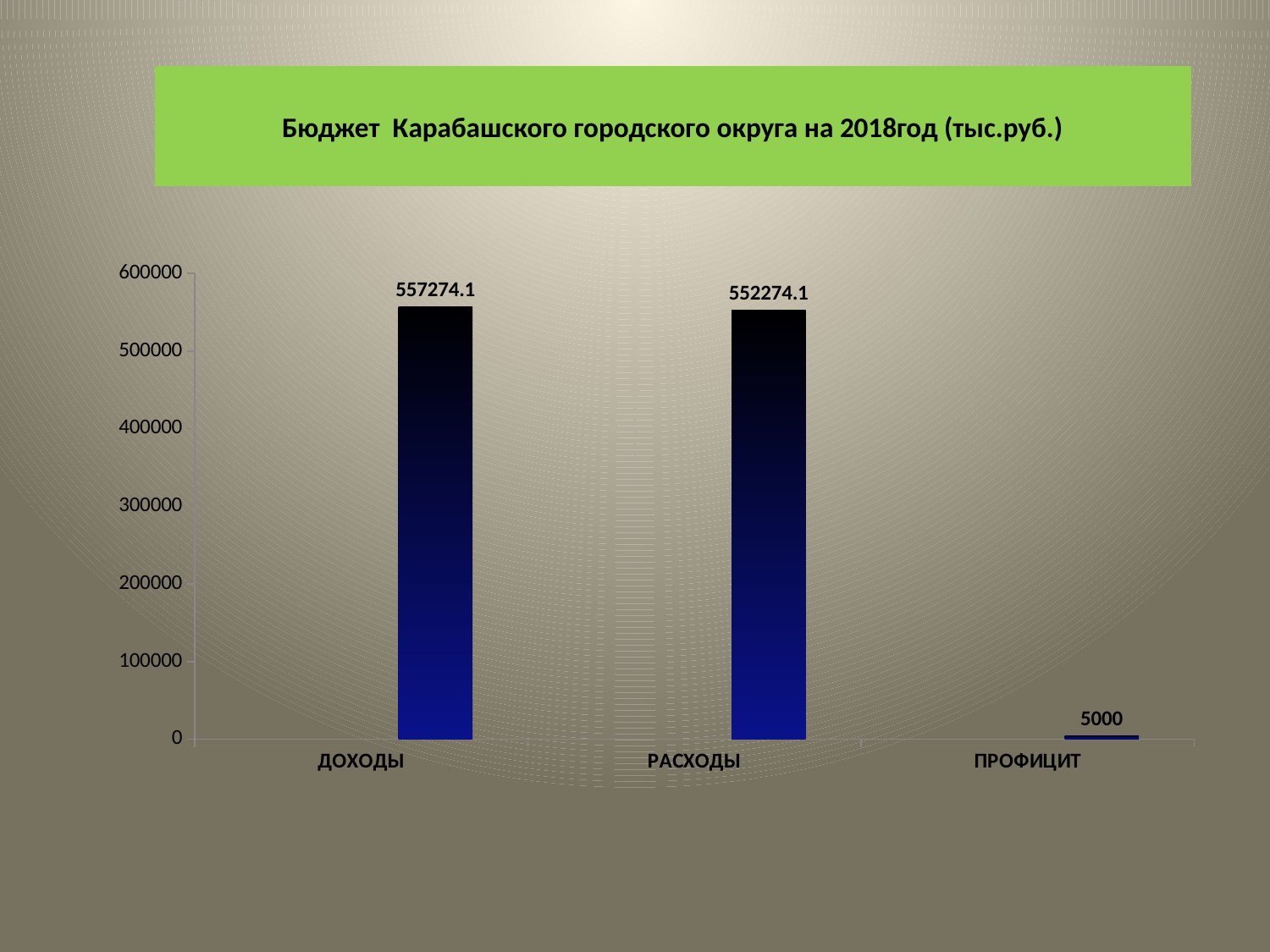
Which category has the highest value? ДОХОДЫ How many categories are shown on the chart? 3 What is the value for ПРОФИЦИТ? 5000 Is the value for ПРОФИЦИТ greater or less than 100000? less Which is larger, ДОХОДЫ or ПРОФИЦИТ? ДОХОДЫ What is the value for РАСХОДЫ? 552274.1 What is the value for ДОХОДЫ? 557274.1 What kind of chart is shown on the slide? bar chart Is the value for РАСХОДЫ greater or less than 500000? greater What is the title of the chart? Бюджет Карабашского городского округа на 2018год (тыс.руб.) What is the difference between ДОХОДЫ and РАСХОДЫ? 5000 Which category has the lowest value? ПРОФИЦИТ